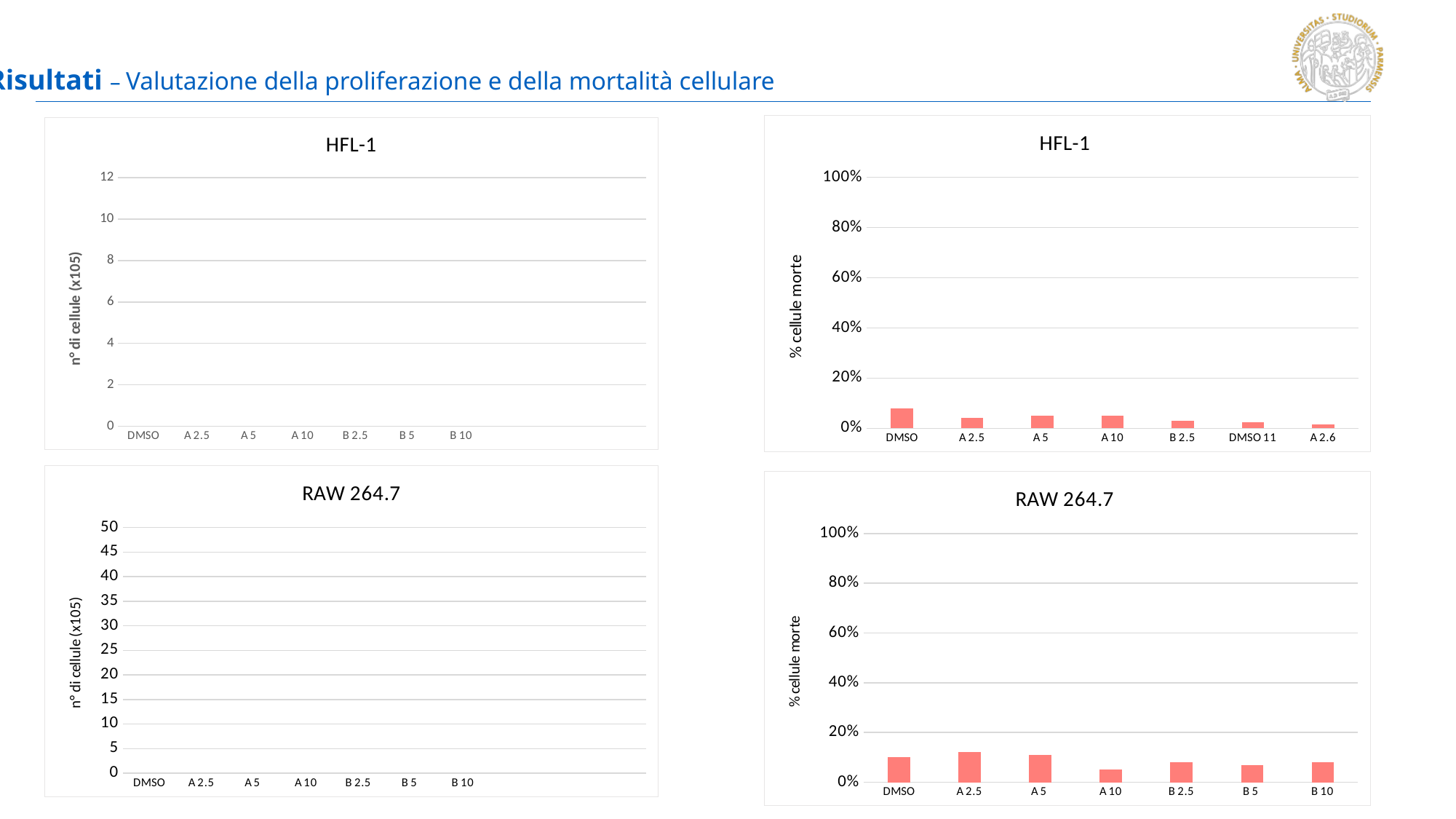
In the bottom-left RAW 264.7 chart, how many categories are listed on the x axis? 7 In the bottom-right RAW 264.7 chart (% cellule morte), is the value for A 2.5 greater or less than 20%? less In the top-right HFL-1 chart (% cellule morte), which category has the highest value? DMSO In the bottom-right RAW 264.7 chart (% cellule morte), which is larger, A 5 or A 10? A 5 What kind of chart is the top-right chart titled HFL-1? bar chart In the top-right HFL-1 chart (% cellule morte), is the value for DMSO greater or less than 20%? less In the bottom-right RAW 264.7 chart (% cellule morte), which category has the lowest value? A 10 In the top-right HFL-1 chart (% cellule morte), which is larger, DMSO or B 2.5? DMSO In the top-right HFL-1 chart (% cellule morte), which category has the lowest value? A 2.6 In the bottom-right RAW 264.7 chart (% cellule morte), which category has the highest value? A 2.5 What is the y-axis label of the bottom-right RAW 264.7 chart? % cellule morte In the top-right HFL-1 chart (% cellule morte), how many categories are shown on the x axis? 7